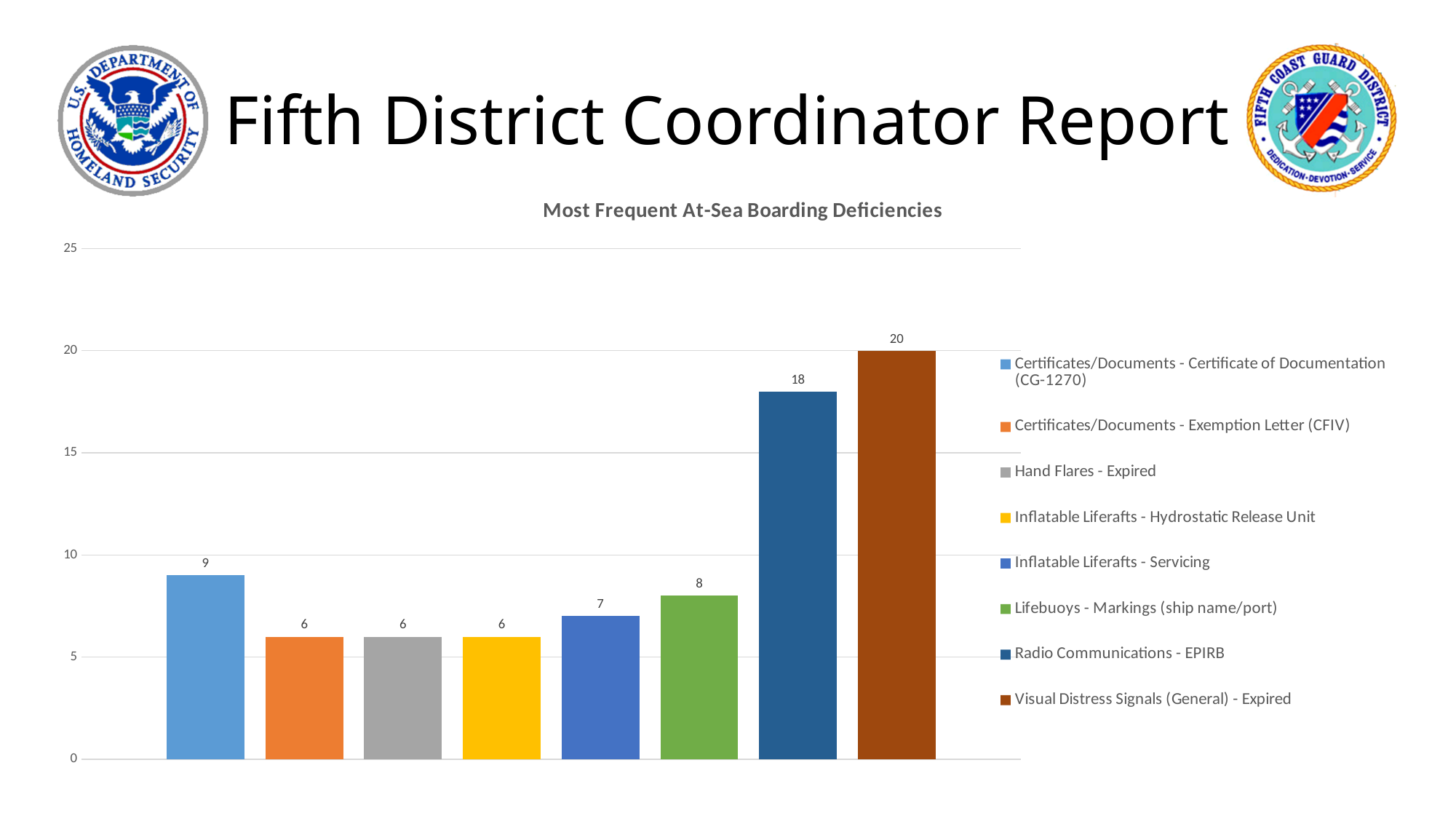
What is the value for Radio Communications - EPIRB? 18 Which is larger, the value for Inflatable Liferafts - Servicing or the value for Hand Flares - Expired? Inflatable Liferafts - Servicing Which deficiency category has the highest value? Visual Distress Signals (General) - Expired Is the value for Radio Communications - EPIRB greater or less than 15? greater What is the value for Visual Distress Signals (General) - Expired? 20 What is the value for Lifebuoys - Markings (ship name/port)? 8 What is the title of the chart? Most Frequent At-Sea Boarding Deficiencies What is the difference between the values for Visual Distress Signals (General) - Expired and Radio Communications - EPIRB? 2 What is the value for Certificates/Documents - Certificate of Documentation (CG-1270)? 9 How many deficiency categories are plotted in the chart? 8 How many entries does the legend list? 8 What kind of chart is shown on the slide? bar chart